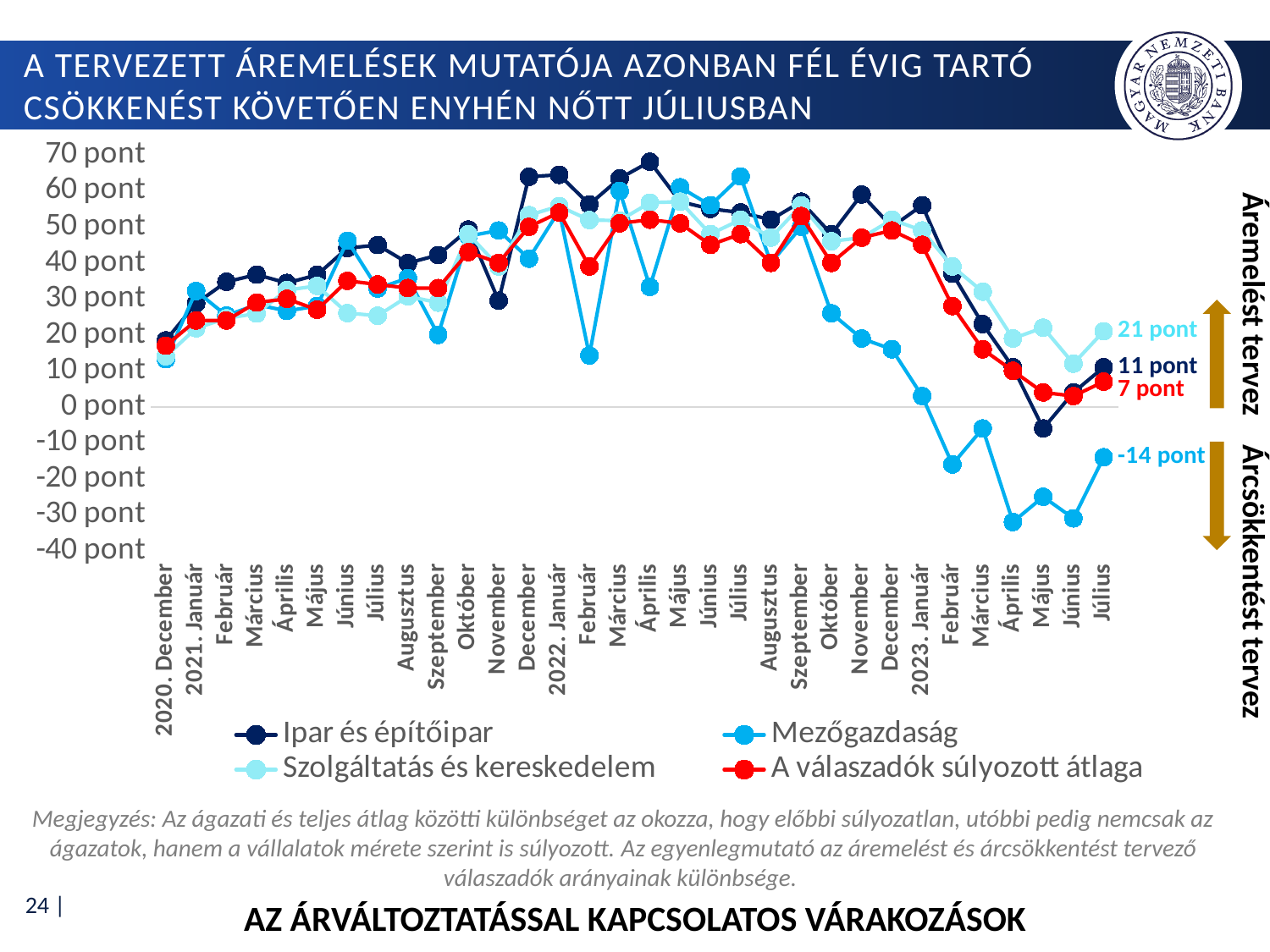
What is the difference between the 2023 Július values of Szolgáltatás és kereskedelem and Mezőgazdaság? 35 pont What is the value for Mezőgazdaság in 2023 Július? -14 pont Which series has the lowest value in 2023 Július? Mezőgazdaság How many series does the legend list? 4 What kind of chart is shown on the slide? line chart Is the value for Mezőgazdaság in 2023 Február greater or less than -10 pont? less Which series has the highest value in 2023 Július? Szolgáltatás és kereskedelem What is the value for Szolgáltatás és kereskedelem in 2023 Július? 21 pont What is the value for A válaszadók súlyozott átlaga in 2023 Július? 7 pont What is the value for Ipar és építőipar in 2023 Július? 11 pont In 2023 Július, which is larger: Ipar és építőipar or A válaszadók súlyozott átlaga? Ipar és építőipar How many months are shown on the x axis? 32